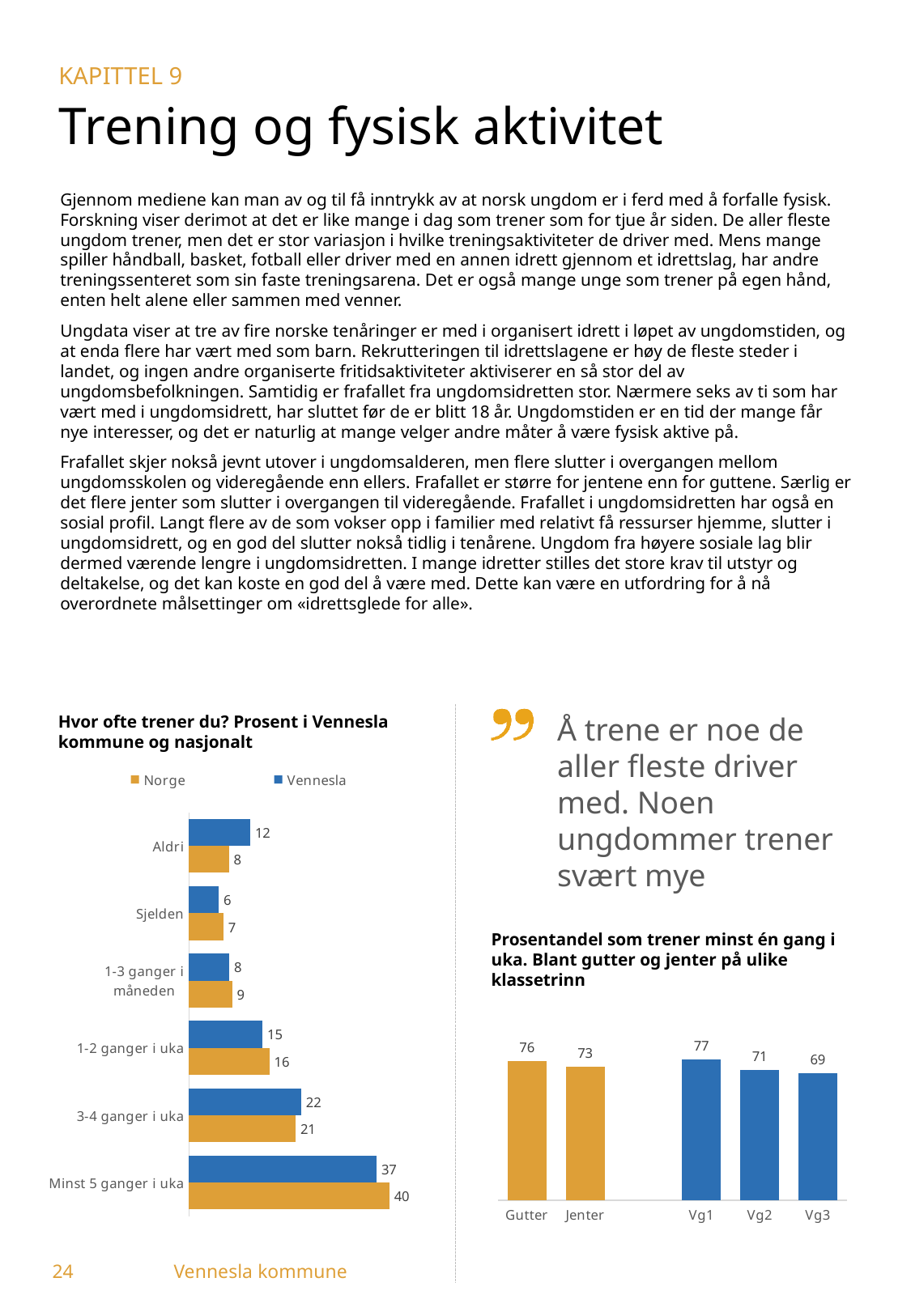
In the chart 'Hvor ofte trener du?', what is the difference between the Norge and Vennesla values for 'Minst 5 ganger i uka'? 3 In the chart 'Hvor ofte trener du?', which category has the highest value for Norge? Minst 5 ganger i uka In the chart 'Hvor ofte trener du?', which is larger for 'Aldri': the Vennesla value or the Norge value? Vennesla In the chart 'Prosentandel som trener minst én gang i uka', which category has the highest value? Vg1 In the chart 'Hvor ofte trener du?', what is the value for Vennesla in the category 'Minst 5 ganger i uka'? 37 In the chart 'Hvor ofte trener du?', what is the value for Norge in the category 'Aldri'? 8 In the chart 'Prosentandel som trener minst én gang i uka', what is the value for Vg2? 71 What kind of chart is 'Prosentandel som trener minst én gang i uka'? Bar chart How many categories are shown in the chart 'Hvor ofte trener du?'? 6 How many series does the legend of the chart 'Hvor ofte trener du?' list? 2 In the chart 'Prosentandel som trener minst én gang i uka', do the values rise or fall from Vg1 to Vg3? Fall In the chart 'Hvor ofte trener du?', which category has the lowest value for Vennesla? Sjelden